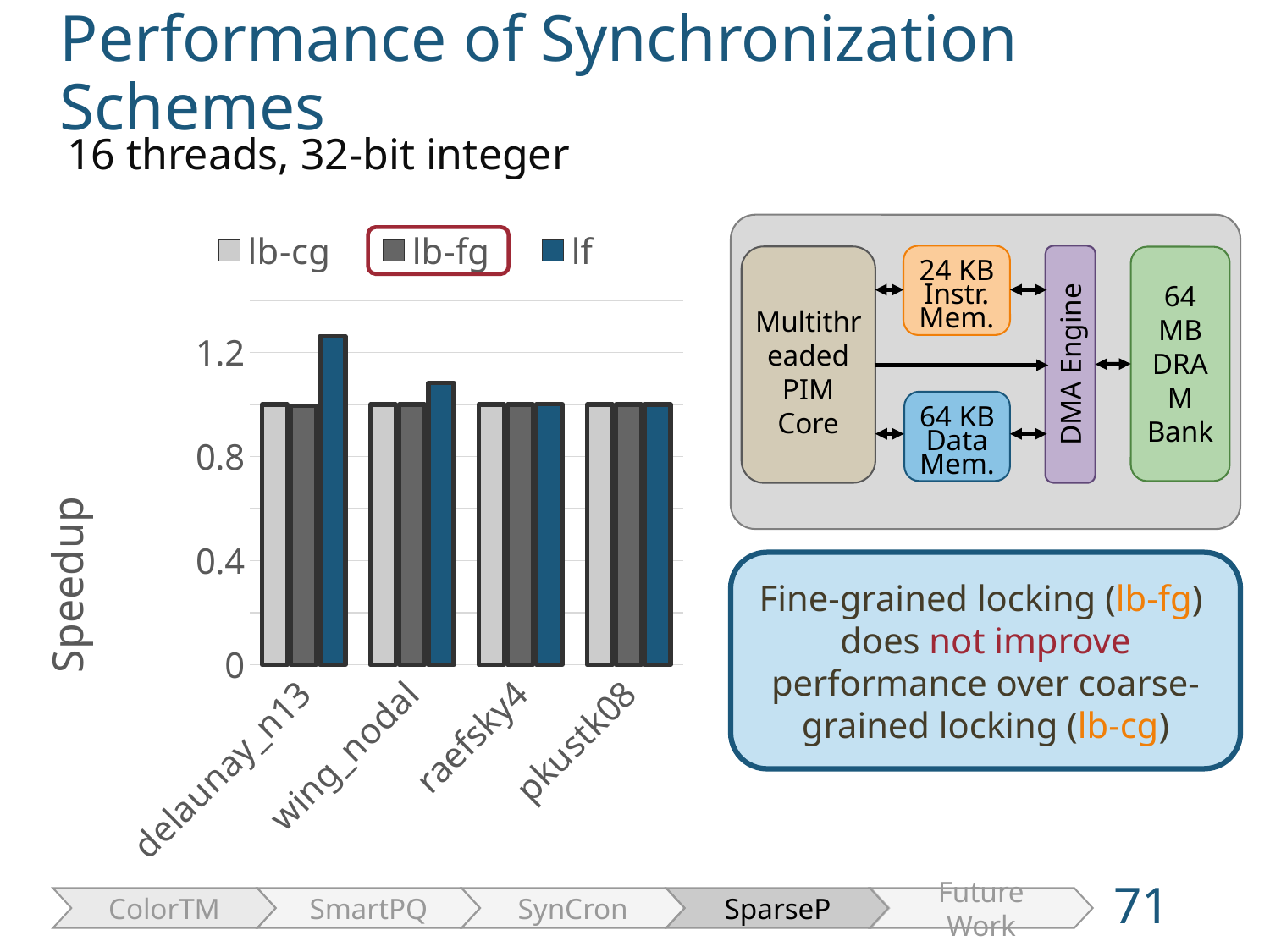
For wing_nodal, which is larger: the lf value or the lb-fg value? lf What kind of chart is shown on the slide? bar chart Is the lf value for pkustk08 greater or less than 1.2? less Is the lb-cg value for raefsky4 greater or less than 0.8? greater Is the lb-fg value for wing_nodal greater or less than 0.4? greater Which legend entry is highlighted with a red box? lb-fg What is the label of the y axis of the chart? Speedup How many categories (matrices) are shown on the x axis of the chart? 4 For delaunay_n13, which is larger: the lf value or the lb-cg value? lf For which category is the lf bar the highest? delaunay_n13 How many series does the chart's legend list? 3